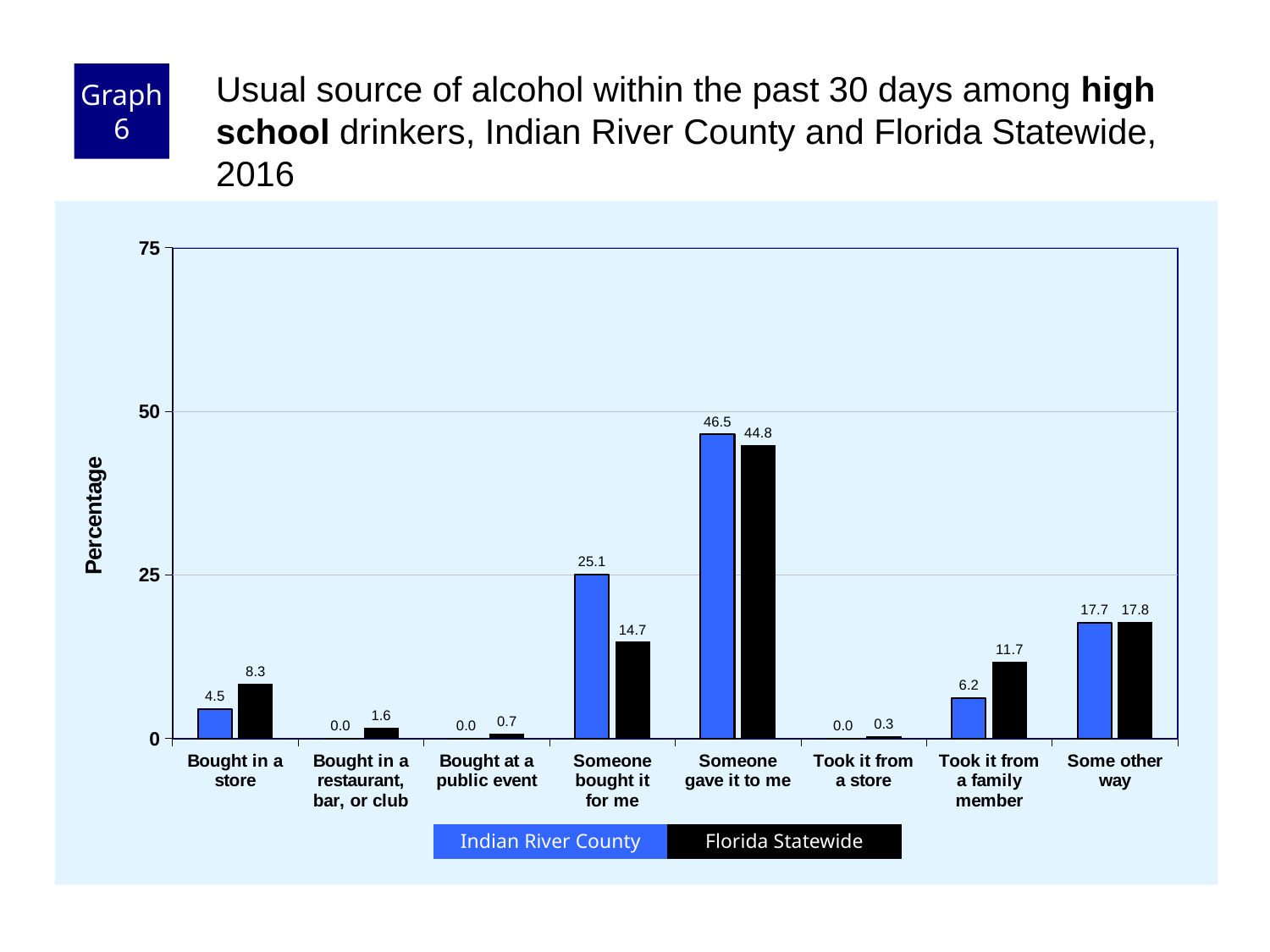
Which category has the lowest Florida Statewide value? Took it from a store What is the difference between the Indian River County and Florida Statewide values for "Someone bought it for me"? 10.4 What is the Florida Statewide value for "Someone bought it for me"? 14.7 Is the Indian River County value for "Someone gave it to me" greater or less than 50? less What is the Indian River County value for "Someone gave it to me"? 46.5 Which category has the highest Indian River County value? Someone gave it to me How many series does the legend list? 2 How many categories are shown on the x axis? 8 What kind of chart is shown on the slide? bar chart For "Bought in a store", which is larger: Indian River County or Florida Statewide? Florida Statewide What is the label of the y axis? Percentage What is the Florida Statewide value for "Took it from a family member"? 11.7